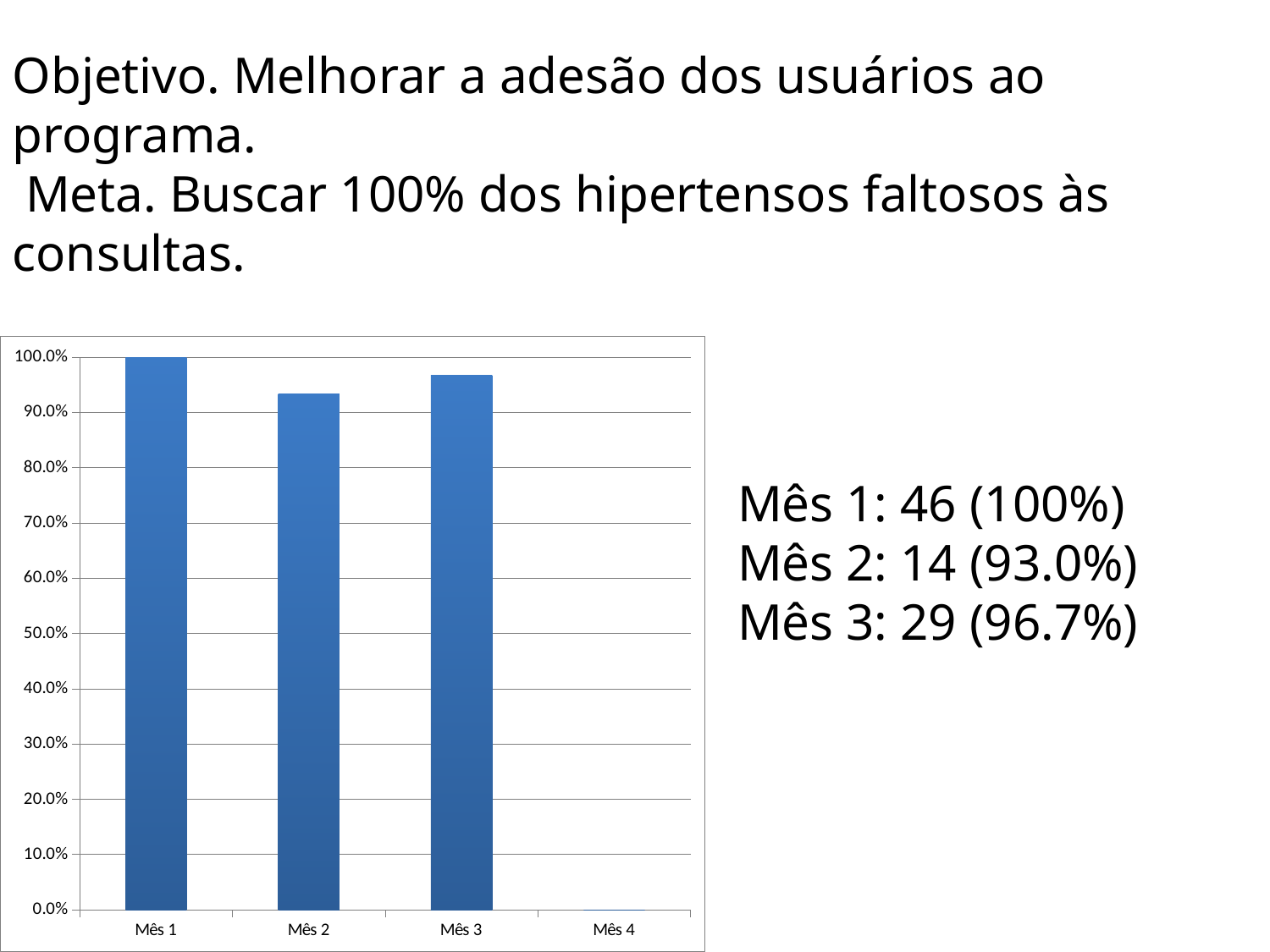
Is the value for Mês 3 greater or less than 100.0%? less Which category on the x axis has no bar plotted? Mês 4 What is the value of the bar for Mês 1? 100.0% According to the text beside the chart, what percentage is given for Mês 2? 93.0% What kind of chart is shown on the slide? bar chart How many categories are labelled on the x axis of the chart? 4 Which category has the highest bar in the chart? Mês 1 Which is larger, the bar for Mês 2 or the bar for Mês 3? Mês 3 Is the value for Mês 2 greater or less than 90.0%? greater According to the text beside the chart, what percentage is given for Mês 3? 96.7% Among the plotted bars, which category has the lowest value? Mês 2 How many bars are plotted in the chart? 3